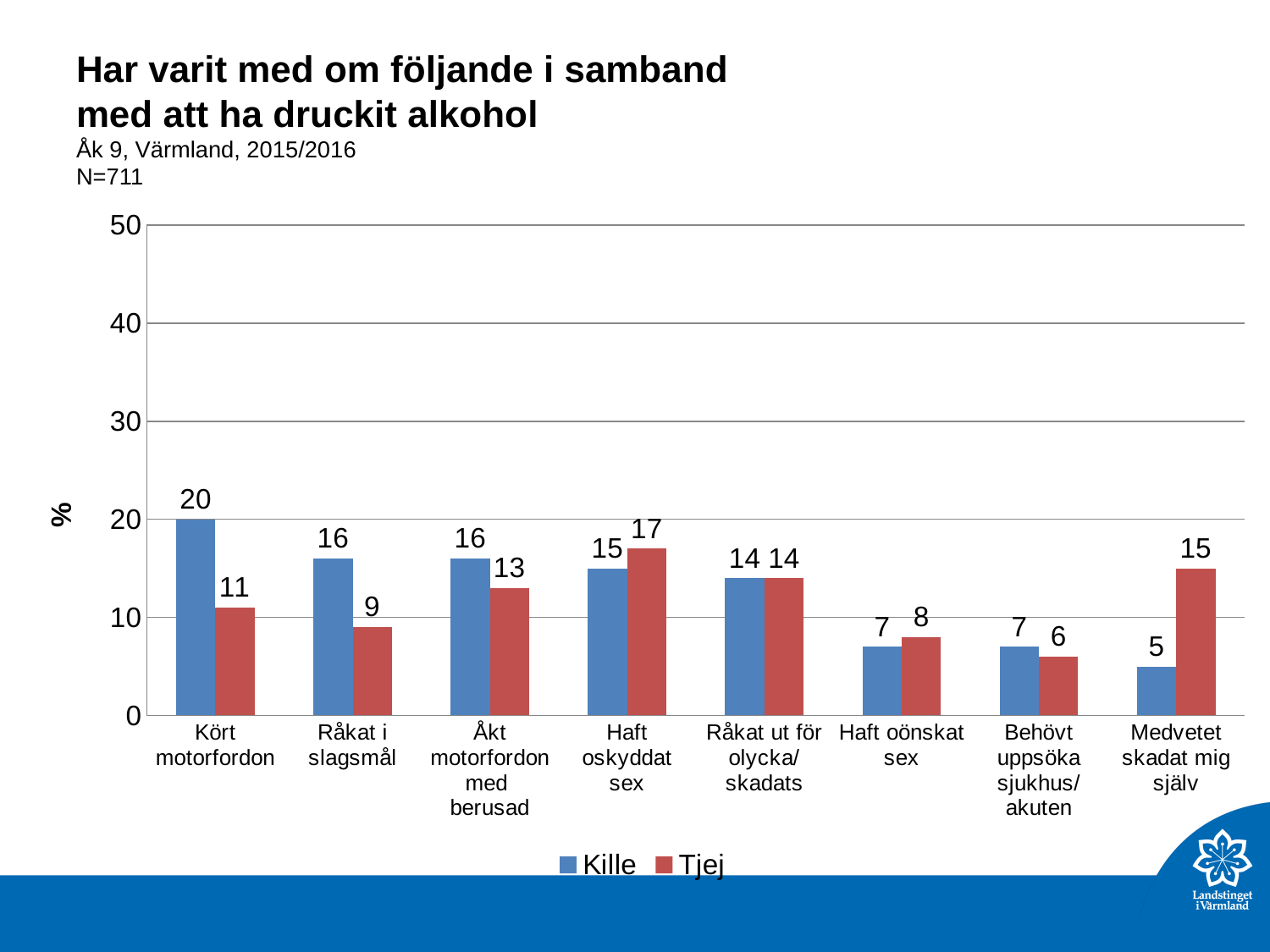
What is the value for Tjej in the 'Råkat ut för olycka/skadats' category? 14 How many categories are shown on the x axis? 8 What is the value for Tjej in the 'Medvetet skadat mig själv' category? 15 Which category has the highest value for Kille? Kört motorfordon What kind of chart is shown on the slide? Bar chart Which is larger in the 'Haft oskyddat sex' category, Kille or Tjej? Tjej Is the value for Kille in 'Råkat i slagsmål' greater or less than 10? greater How many series does the legend list? 2 What is the value for Kille in the 'Kört motorfordon' category? 20 What is the sample size (N) stated on the slide? N=711 Which category has the lowest value for Tjej? Behövt uppsöka sjukhus/akuten What is the difference between the Kille and Tjej values for 'Kört motorfordon'? 9